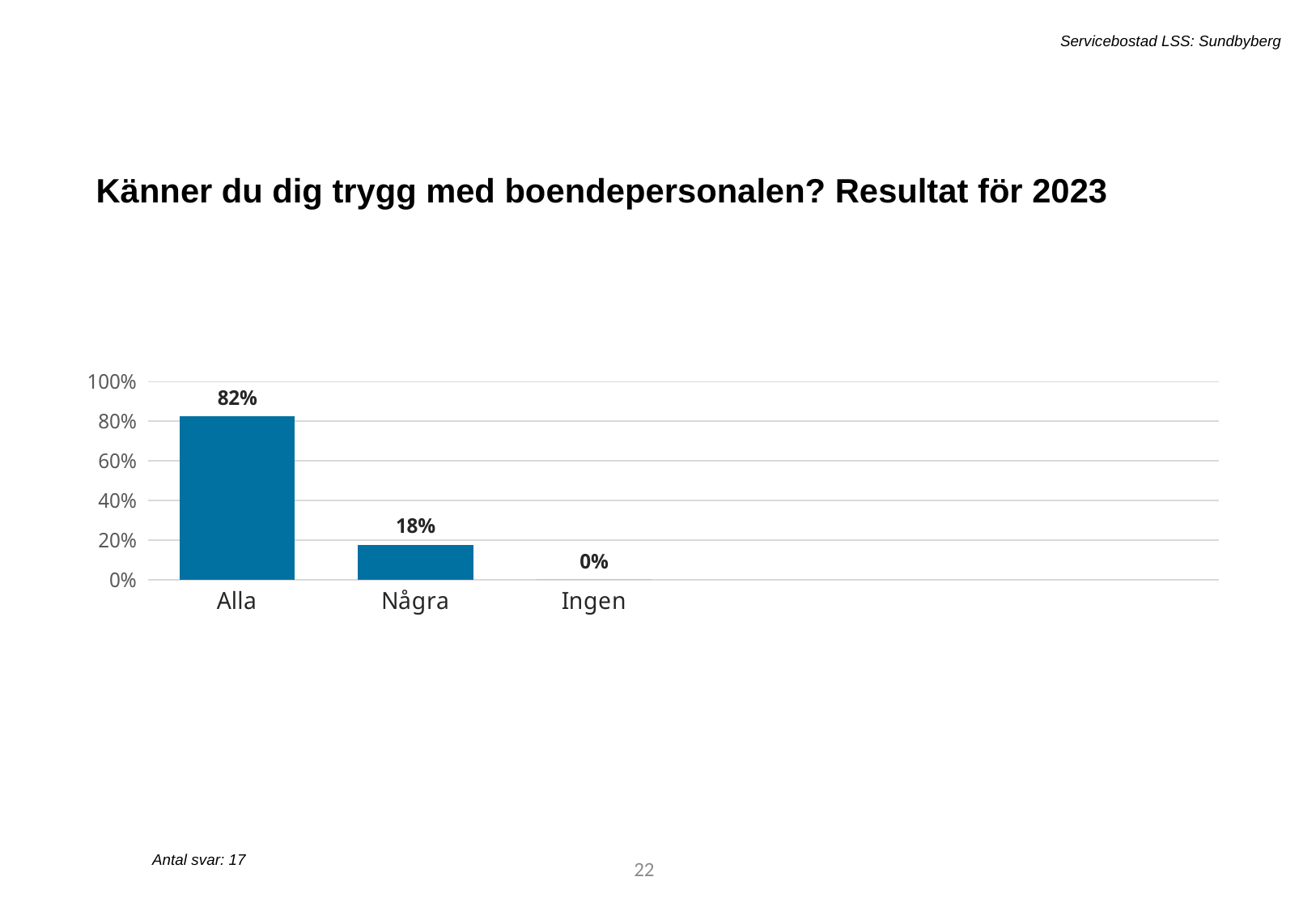
Which is larger, the value for Några or the value for Ingen? Några What kind of chart is shown on the slide? bar chart How many categories are shown on the x axis? 3 Is the value for Alla greater or less than 60%? greater Which category has the lowest value? Ingen What is the value for Ingen? 0% What is the title of the chart? Känner du dig trygg med boendepersonalen? Resultat för 2023 What is the difference between the values for Alla and Några? 64% What is the value for Alla? 82% Do the values rise or fall from left to right along the x axis? fall What is the value for Några? 18% Which category has the highest value? Alla